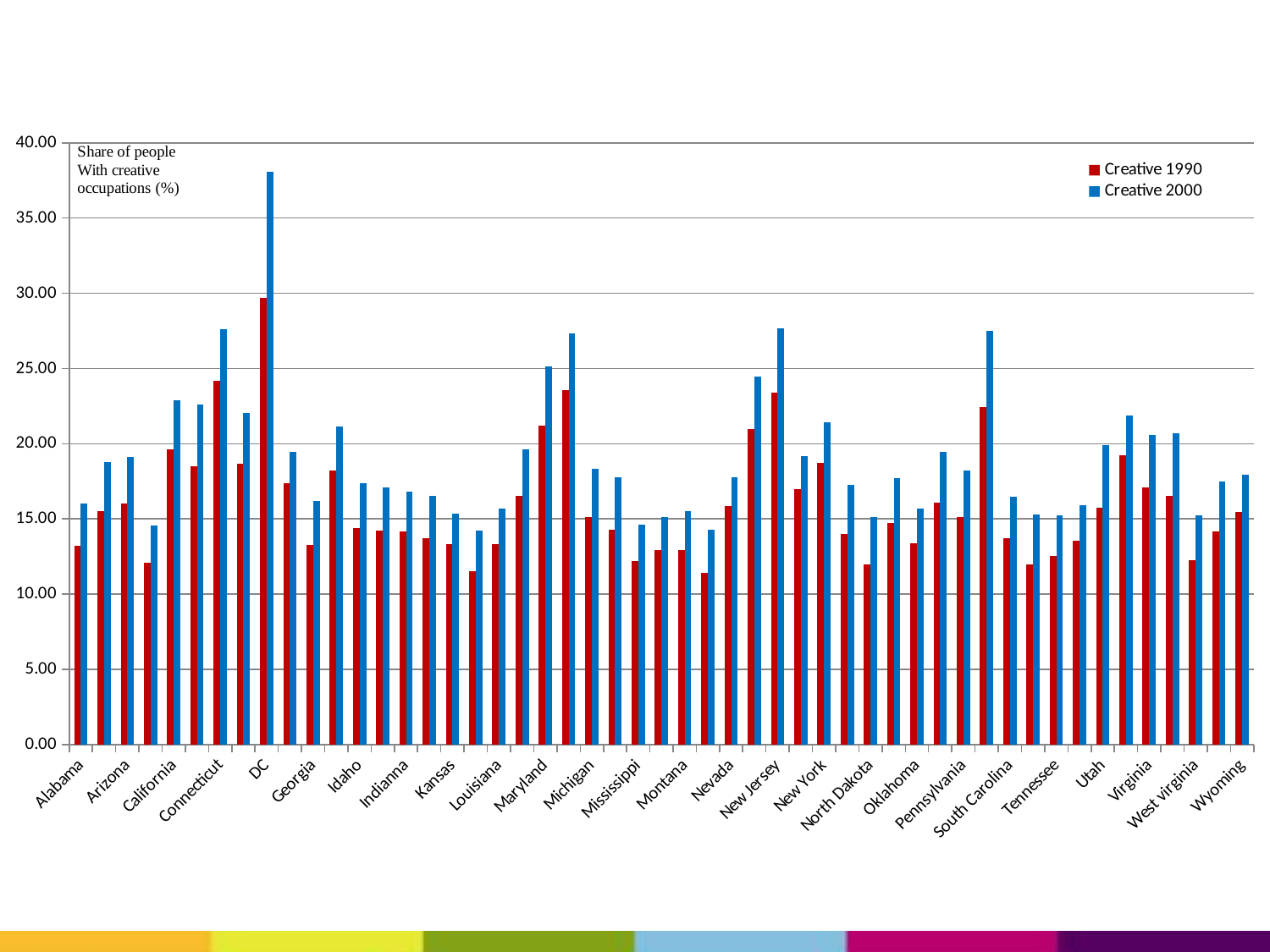
Is the Creative 2000 value for DC greater or less than 35.00? greater What colour are the Creative 1990 bars? red How many series does the legend list? 2 Which category has the highest Creative 2000 value? DC Is the Creative 2000 value for New Jersey greater or less than 25.00? greater What are the two series named in the legend? Creative 1990 and Creative 2000 What kind of chart is shown on the slide? bar chart For Maryland, which series has the larger value, Creative 1990 or Creative 2000? Creative 2000 Is the Creative 1990 value for DC greater or less than 25.00? greater Which category has the highest Creative 1990 value? DC